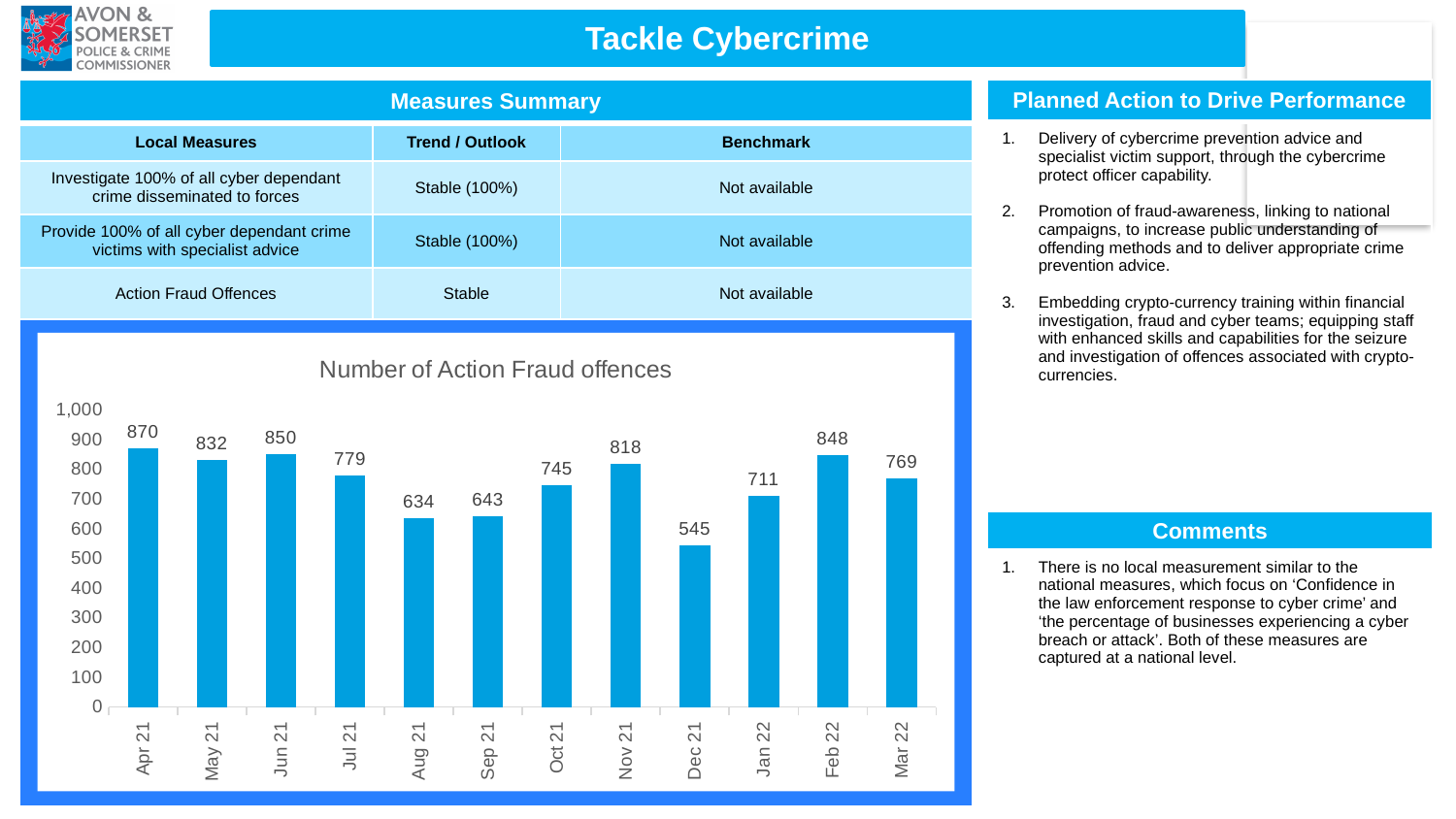
What is the difference between the number of Action Fraud offences in Feb 22 and Mar 22? 79 Which month has more Action Fraud offences, Jul 21 or Jan 22? Jul 21 How many months are shown in the Number of Action Fraud offences chart? 12 What kind of chart is used to show the Number of Action Fraud offences? Bar chart Which month has the lowest number of Action Fraud offences? Dec 21 What is the number of Action Fraud offences in Apr 21? 870 What is the difference between the number of Action Fraud offences in Apr 21 and Dec 21? 325 What is the number of Action Fraud offences in Dec 21? 545 Is the value for Nov 21 greater or less than 700? greater What is the number of Action Fraud offences in Feb 22? 848 Which month has the highest number of Action Fraud offences? Apr 21 What is the title of the chart on the slide? Number of Action Fraud offences